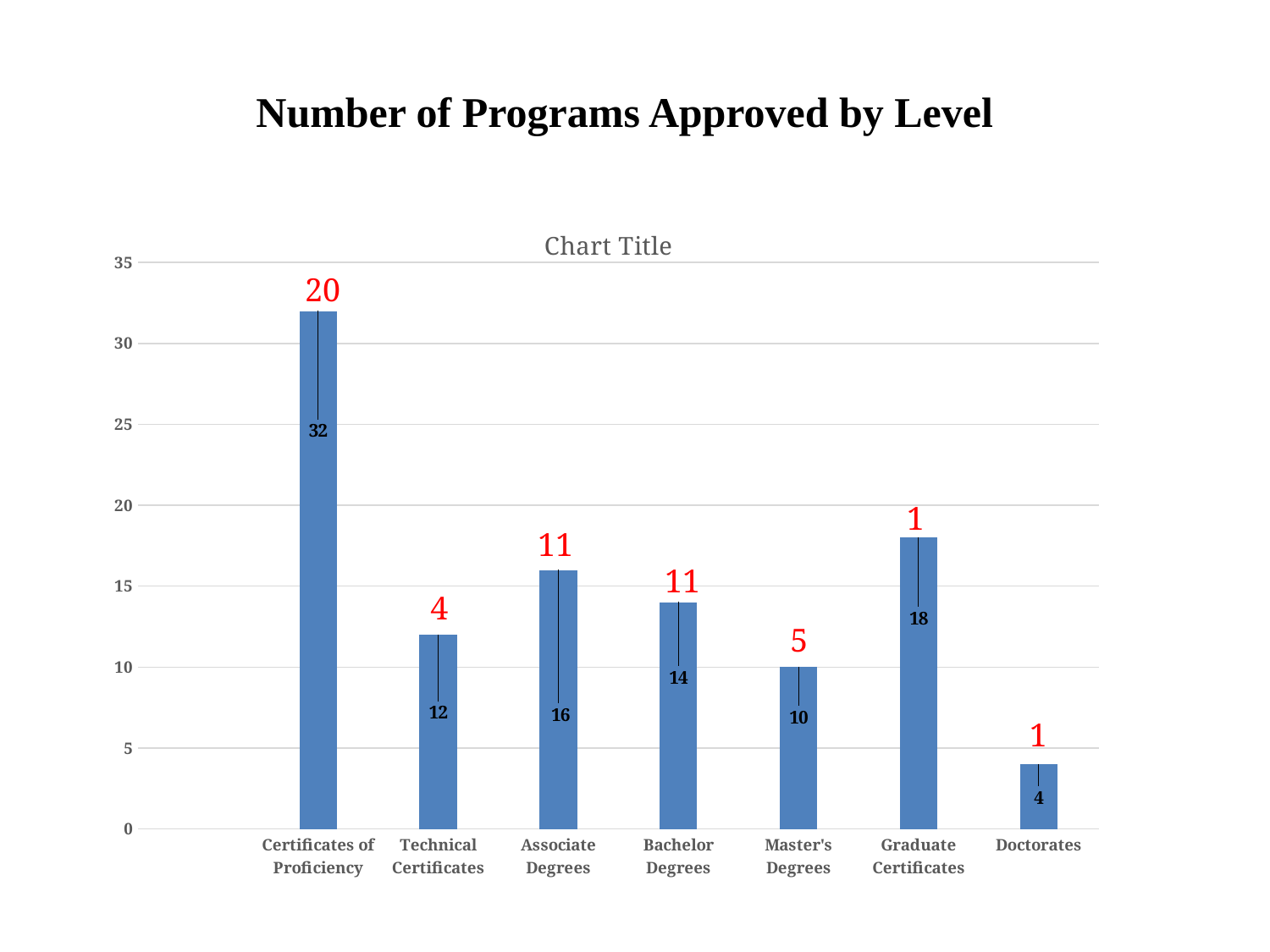
What is the value of the bar for Graduate Certificates? 18 What is the title of the slide above the chart? Number of Programs Approved by Level What is the value of the bar for Master's Degrees? 10 What is the value of the bar for Certificates of Proficiency? 32 What is the difference between the bar values for Certificates of Proficiency and Graduate Certificates? 14 What is the difference between the bar values for Associate Degrees and Bachelor Degrees? 2 How many categories are shown on the x axis? 7 Is the bar value for Bachelor Degrees greater or less than 15? less Which has a larger bar value, Technical Certificates or Associate Degrees? Associate Degrees What kind of chart is shown on the slide? bar chart Which category has the highest bar? Certificates of Proficiency Which category has the lowest bar? Doctorates